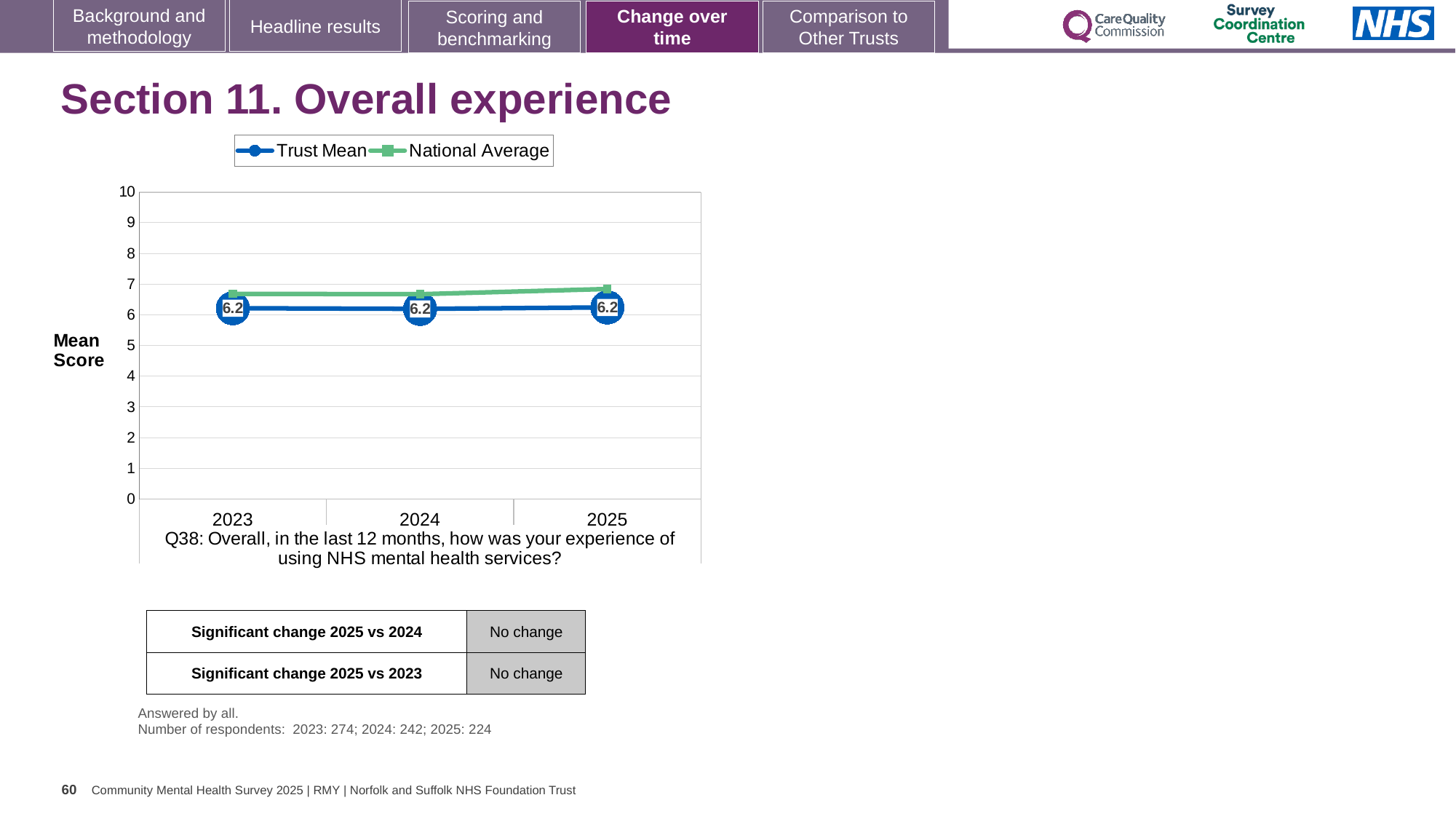
What is the Trust Mean score for 2024? 6.2 In 2023, which is lower: the Trust Mean or the National Average? Trust Mean How many years are plotted on the x axis? 3 In 2025, which is higher: the Trust Mean or the National Average? National Average Is the National Average for 2025 greater or less than 6? greater What is the Trust Mean score for 2025? 6.2 What kind of chart is shown on the slide? Line chart What is the Trust Mean score for 2023? 6.2 What is the label on the y axis of the chart? Mean Score Is the National Average for 2023 greater or less than 7? less Does the Trust Mean rise, fall or stay the same from 2023 to 2025? Stays the same How many series does the legend list? 2